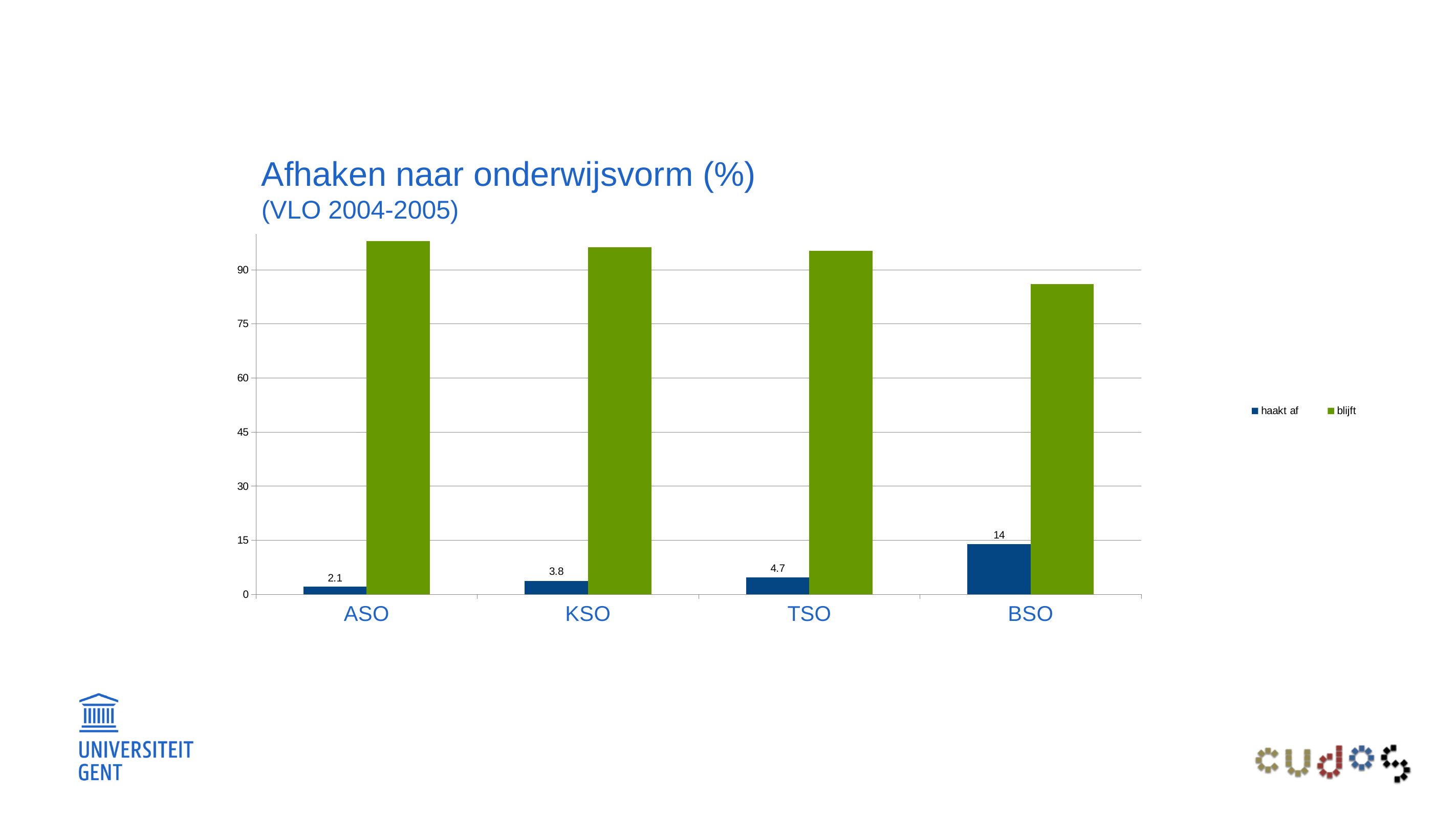
What is the 'haakt af' value for TSO? 4.7 Which is larger, the 'haakt af' value for TSO or for KSO? TSO Is the 'blijft' value for ASO greater or less than 90? greater Which category has the highest 'haakt af' value? BSO How many series does the legend list? 2 What kind of chart is shown on the slide? bar chart What is the 'haakt af' value for ASO? 2.1 What is the difference between the 'haakt af' values for BSO and KSO? 10.2 How many categories are shown on the x axis? 4 Is the 'blijft' value for BSO greater or less than 90? less What is the 'haakt af' value for BSO? 14 Which category has the lowest 'haakt af' value? ASO